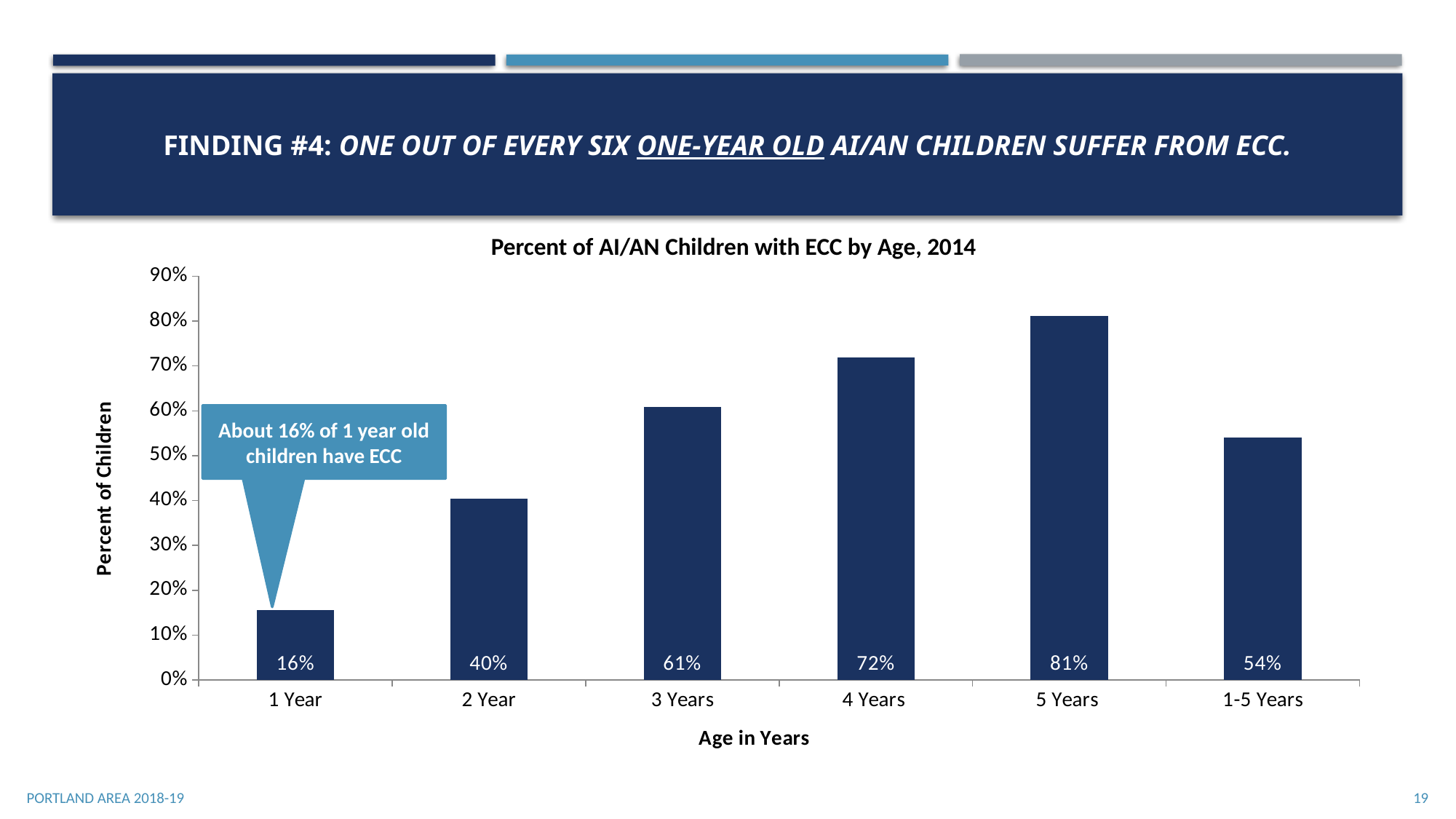
Which age category has the lowest percent of children with ECC? 1 Year What is the difference between the values for 5 Years and 1 Year? 65% How many age categories are shown on the x axis? 6 What is the title of the chart? Percent of AI/AN Children with ECC by Age, 2014 What is the value for 3 Years? 61% Is the value for 4 Years greater or less than 70%? greater What kind of chart is shown on the slide? bar chart What is the value for 1-5 Years? 54% Which is larger, the value for 3 Years or the value for 1-5 Years? 3 Years Which age category has the highest percent of children with ECC? 5 Years What is the difference between the values for 4 Years and 2 Year? 32% What is the value for 1 Year? 16%